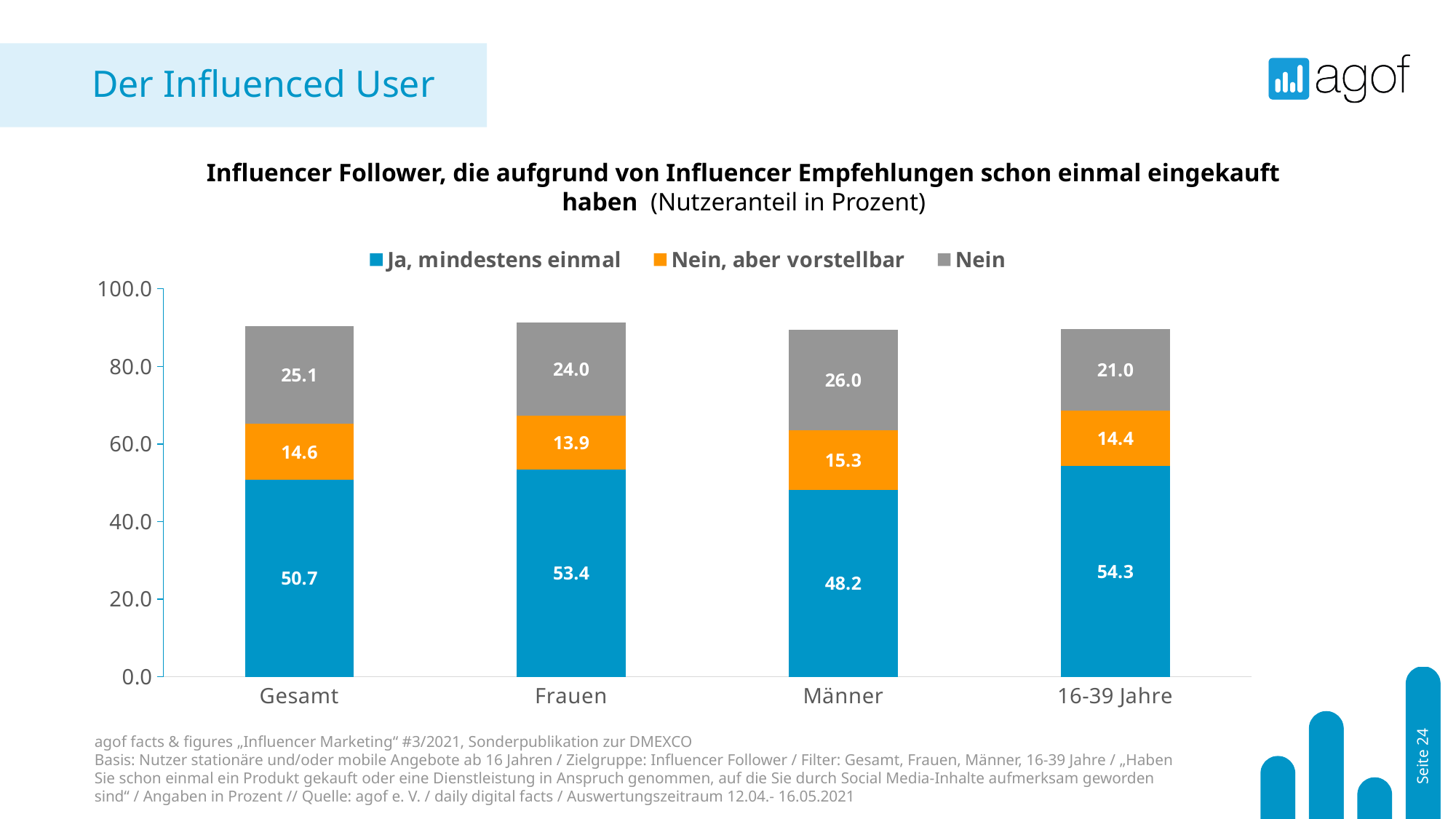
What is the value of "Ja, mindestens einmal" for Männer? 48.2 What kind of chart is shown on the slide? Stacked bar chart What is the total of the stacked bar for Gesamt? 90.4 Which category has the lowest value for "Nein"? 16-39 Jahre How many series does the legend list? 3 What is the value of "Nein, aber vorstellbar" for Frauen? 13.9 What is the value of "Nein" for 16-39 Jahre? 21.0 What is the difference between the "Ja, mindestens einmal" values for Frauen and Männer? 5.2 How many categories are shown on the x axis? 4 Which legend entry is shown in orange? Nein, aber vorstellbar Which category has the highest value for "Ja, mindestens einmal"? 16-39 Jahre Which is larger: the "Nein" value for Gesamt or for Frauen? Gesamt